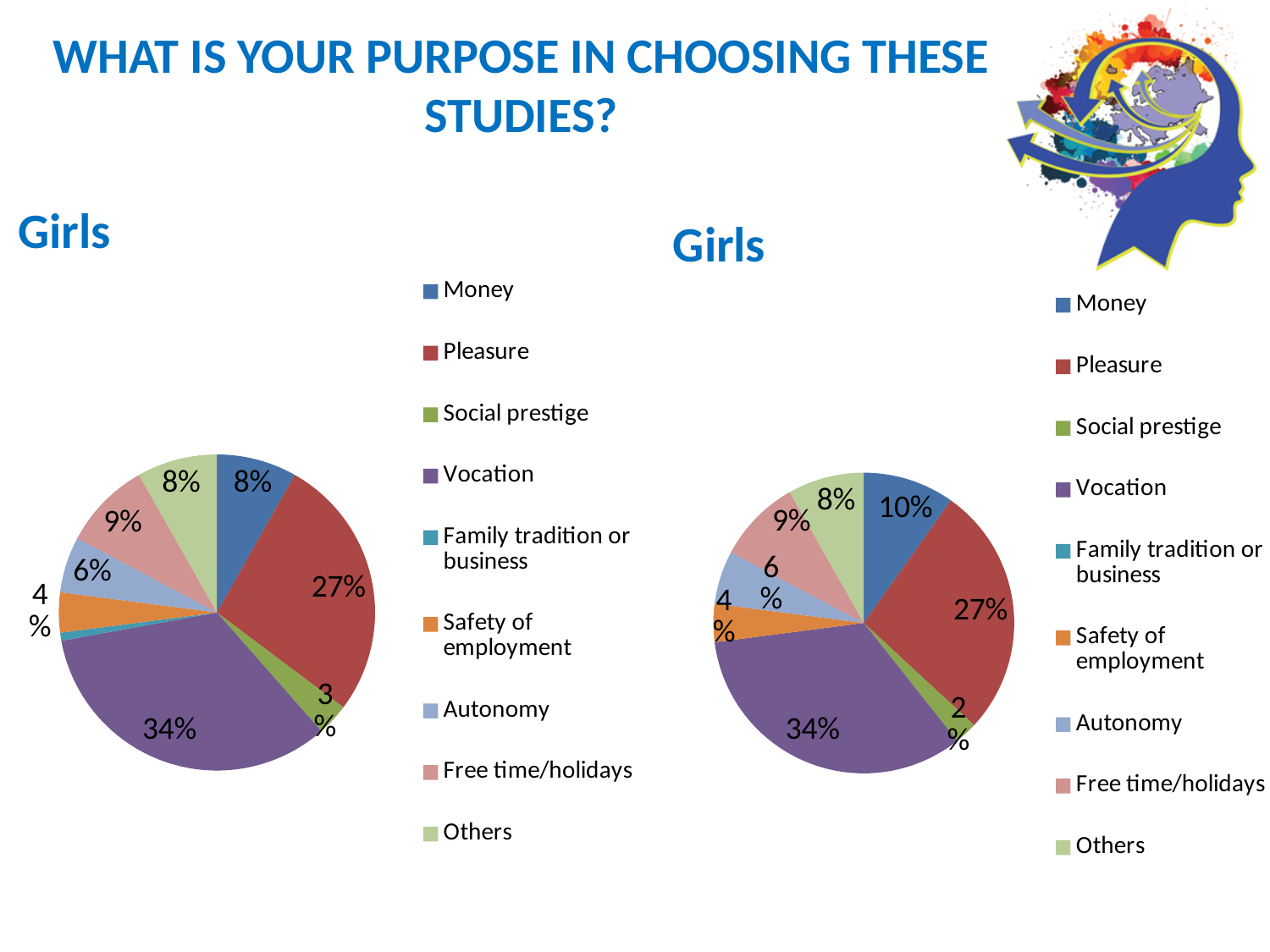
In the left pie chart, what share is Vocation? 34% How many entries does the legend of the right chart list? 9 What is the title of the right chart? Girls In the right pie chart, what share is Social prestige? 2% In the right pie chart, which category has the largest share? Vocation In the left pie chart, what is the difference between the Vocation share and the Pleasure share? 7% In the right pie chart, which is larger, Free time/holidays or Autonomy? Free time/holidays In the left pie chart, what share is Pleasure? 27% What type of chart is shown on the left of the slide? Pie chart In the left pie chart, which category has the largest share? Vocation In the left pie chart, what share is Autonomy? 6% In the right pie chart, what share is Money? 10%